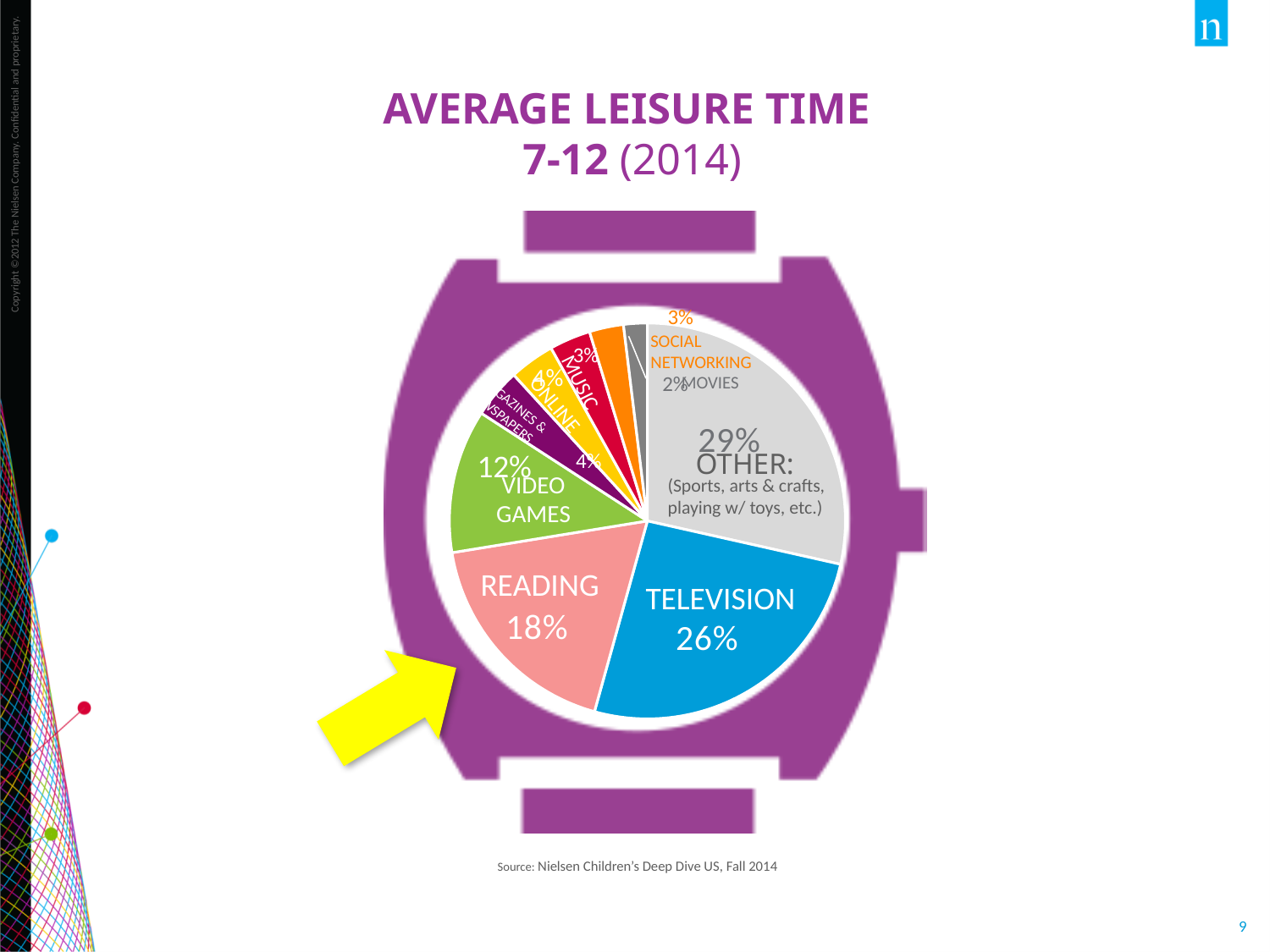
What type of chart is shown on the slide? Pie chart What is the title of the chart? Average Leisure Time 7-12 (2014) What percentage of average leisure time is spent on video games? 12% Which category takes the largest share of average leisure time? Other What percentage of average leisure time is spent on television? 26% Which category takes the smallest share of average leisure time? Movies Which takes a larger share of leisure time, television or video games? Television How many percentage points larger is the television share than the reading share? 8 percentage points What percentage of average leisure time is spent on reading? 18% What percentage of average leisure time is spent on movies? 2% What percentage of average leisure time is spent on social networking? 3% What percentage of average leisure time falls under 'Other' (sports, arts & crafts, playing w/ toys, etc.)? 29%